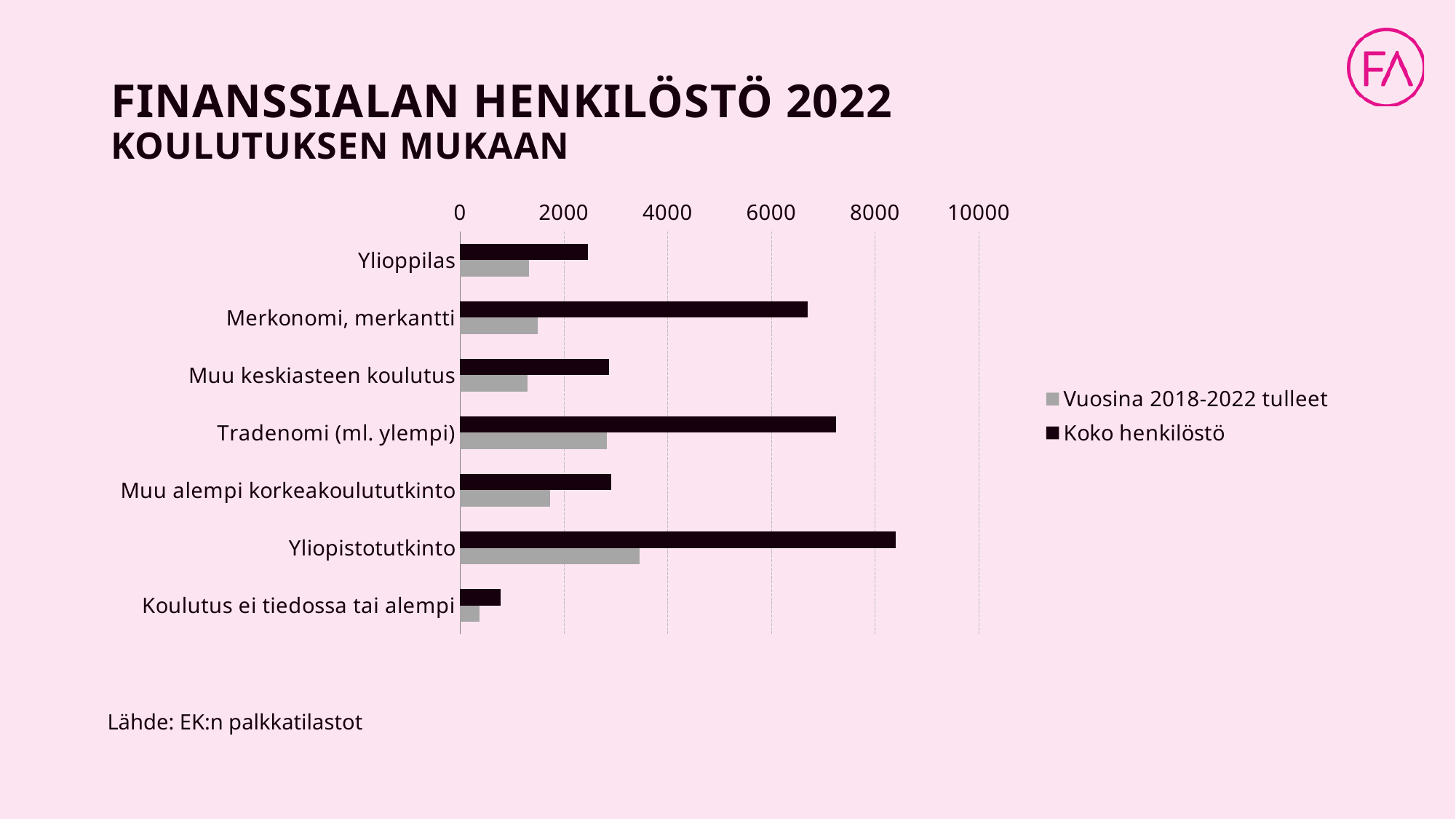
Is the Koko henkilöstö value for Merkonomi, merkantti greater or less than 6000? greater How many series does the legend list? 2 Which category has the highest value for Vuosina 2018-2022 tulleet? Yliopistotutkinto Which category has the lowest value for Koko henkilöstö? Koulutus ei tiedossa tai alempi For Koko henkilöstö, which is larger: Tradenomi (ml. ylempi) or Merkonomi, merkantti? Tradenomi (ml. ylempi) Which category has the highest value for Koko henkilöstö? Yliopistotutkinto Is the Vuosina 2018-2022 tulleet value for Yliopistotutkinto greater or less than 4000? less What is the source cited below the chart? EK:n palkkatilastot Is the Koko henkilöstö value for Yliopistotutkinto greater or less than 8000? greater What kind of chart is shown on the slide? bar chart How many education categories are shown on the chart? 7